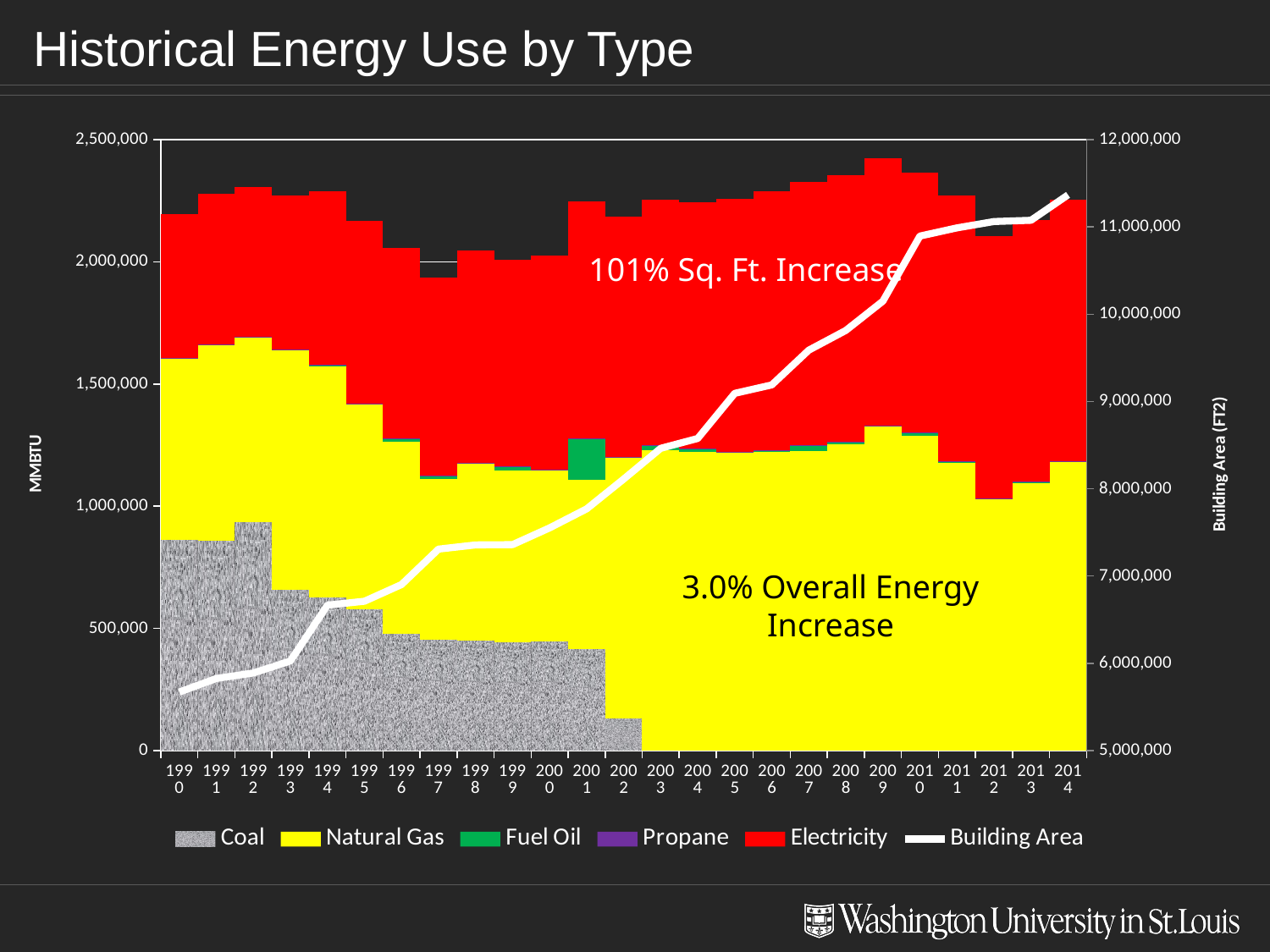
Which is the last year in which Coal appears in the stack? 2002 Is the value for Coal in 2002 greater or less than 500,000 MMBTU? less What is the title of the chart? Historical Energy Use by Type Is the Building Area value in 1990 greater or less than 6,000,000 FT2? less Is the value for Coal in 1990 greater or less than 500,000 MMBTU? greater What kind of chart is used for the Building Area series? Line chart Does the Building Area line rise or fall from 1990 to 2014? Rises Does the Coal series rise or fall from 1990 to 2002? Falls How many series does the legend list? 6 How many years are shown along the x axis? 25 Which is larger, the Building Area value in 2010 or in 2000? 2010